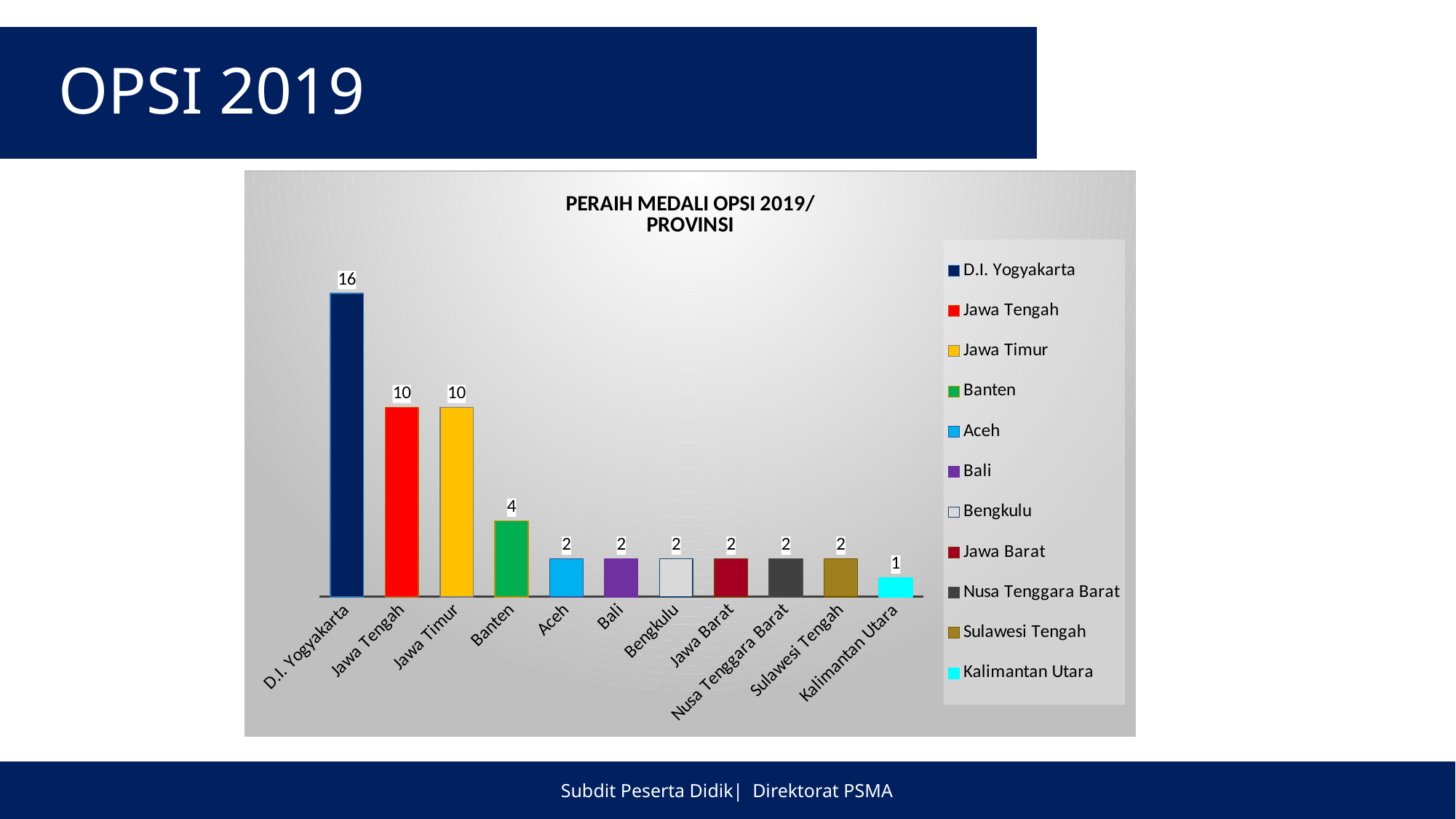
What is the difference between the values for D.I. Yogyakarta and Jawa Tengah? 6 How many entries does the legend list? 11 Which province has the highest value in the chart? D.I. Yogyakarta What is the value shown for Kalimantan Utara? 1 Which is larger, the value for Jawa Timur or the value for Banten? Jawa Timur How many medals did D.I. Yogyakarta win according to the chart? 16 What is the difference between the values for Banten and Aceh? 2 What is the value shown for Banten? 4 What is the title of the chart? PERAIH MEDALI OPSI 2019/ PROVINSI What kind of chart is shown on the slide? Bar chart Which province has the lowest value in the chart? Kalimantan Utara How many provinces are shown on the x axis of the chart? 11